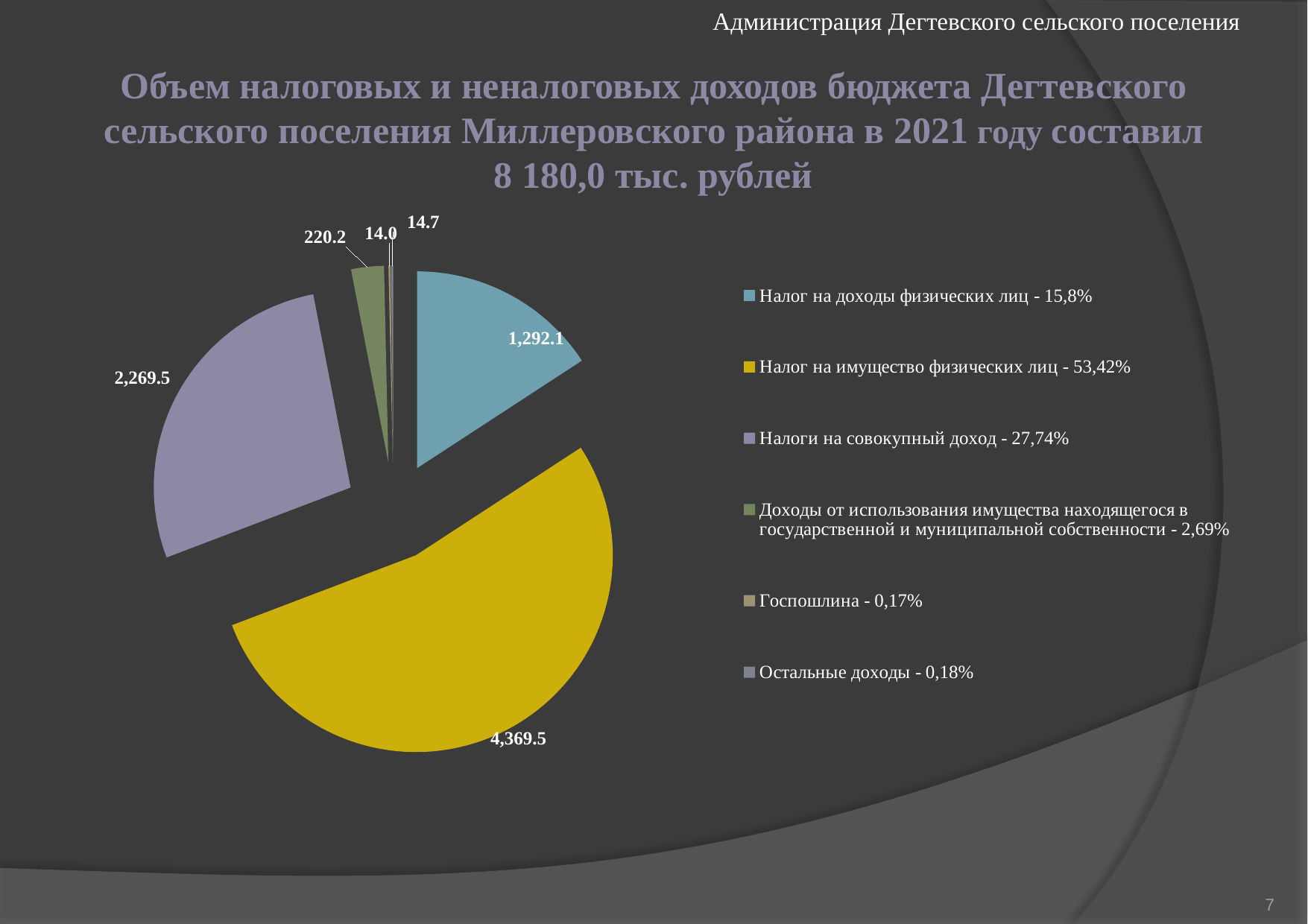
What is the value for Доходы от использования имущества находящегося в государственной и муниципальной собственности? 220.2 How many slices does the pie chart have? 6 Which category has the largest slice of the pie? Налог на имущество физических лиц What is the value for Налог на имущество физических лиц? 4,369.5 What share of the pie does Налоги на совокупный доход represent, according to the legend? 27,74% What is the difference between the values for Налог на имущество физических лиц and Налоги на совокупный доход? 2,100.0 What kind of chart is shown on the slide? pie chart Which category has the smallest slice of the pie? Госпошлина What is the value for Налог на доходы физических лиц? 1,292.1 What is the value for Налоги на совокупный доход? 2,269.5 Which is larger: the value for Налоги на совокупный доход or the value for Налог на доходы физических лиц? Налоги на совокупный доход What colour is the slice for Налог на имущество физических лиц? yellow